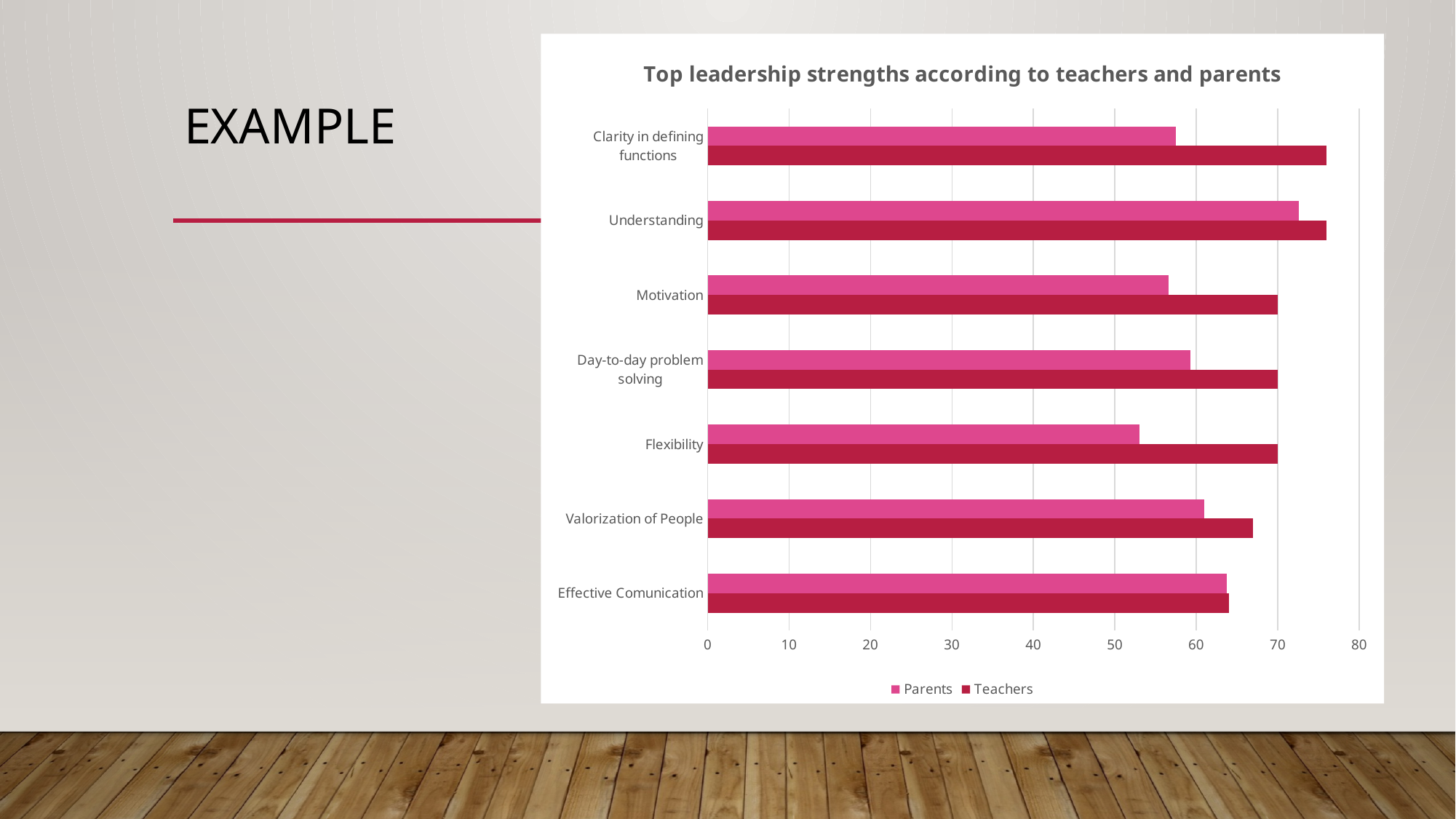
How many series does the legend list? 2 For Understanding, which is larger: the Parents value or the Teachers value? Teachers Which category has the lowest value for Teachers? Effective Comunication Is the Parents value for Flexibility greater or less than 60? less What is the title of the chart? Top leadership strengths according to teachers and parents Which category has the highest value for Parents? Understanding Is the Parents value for Understanding greater or less than 70? greater Is the Teachers value for Clarity in defining functions greater or less than 70? greater What type of chart is shown on the slide? Bar chart How many leadership strengths (categories) are shown on the chart? 7 Which category has the lowest value for Parents? Flexibility For Flexibility, which is larger: the Parents value or the Teachers value? Teachers